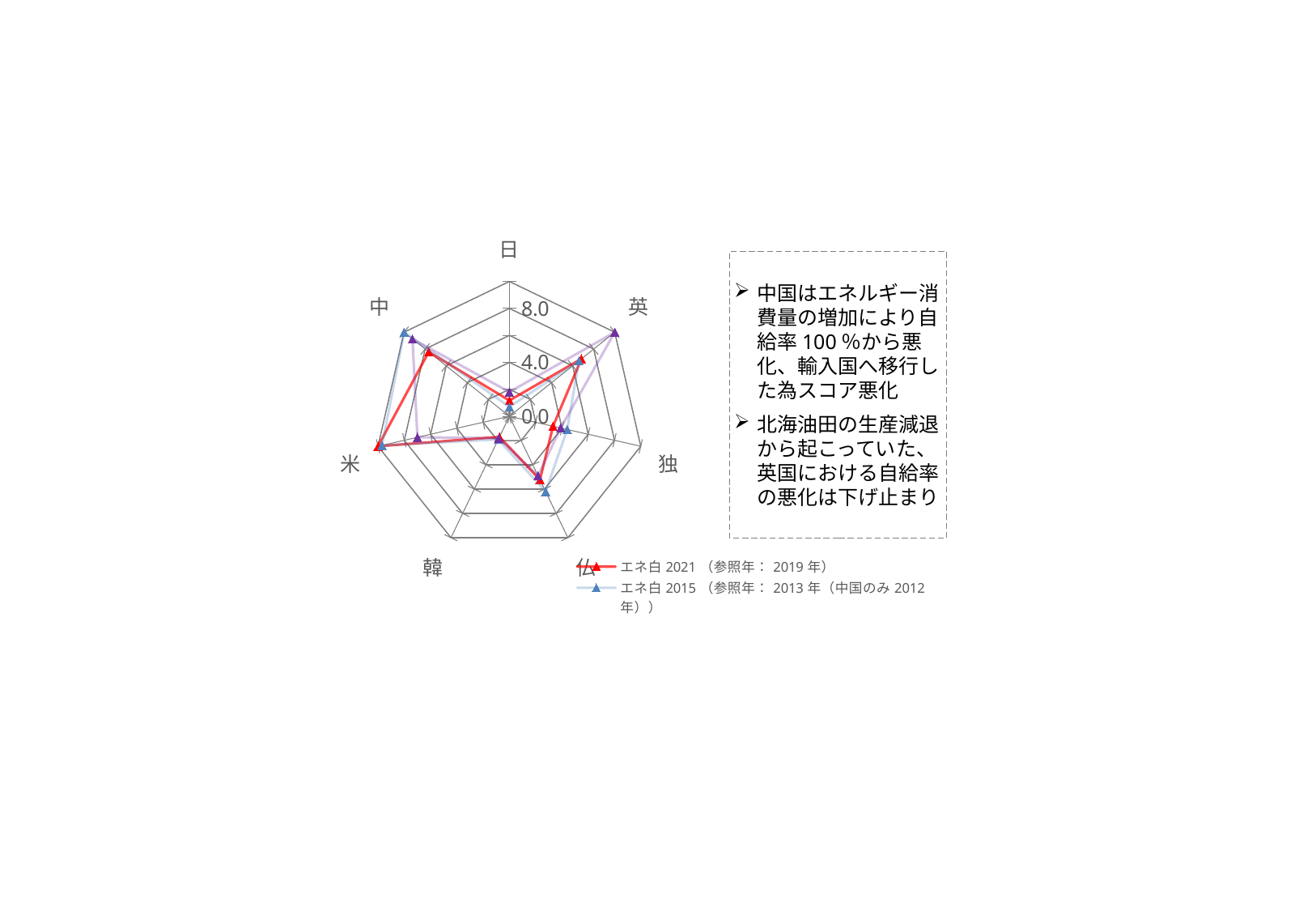
For 米, which series has the larger value, エネ白2021 or エネ白2015? エネ白2021 Is the エネ白2021 value for 仏 greater or less than 4.0? greater How many countries (axes) does the radar chart have? 7 How many series does the legend list? 2 For 中, which series has the larger value, エネ白2021 or エネ白2015? エネ白2015 Is the エネ白2021 value for 日 greater or less than 4.0? less What is the reference year shown in the legend for the エネ白2021 series? 2019年 Is the エネ白2015 value for 中 greater or less than 8.0? greater Which country has the highest value for the エネ白2021 series? 米 What kind of chart is shown on the slide? radar chart